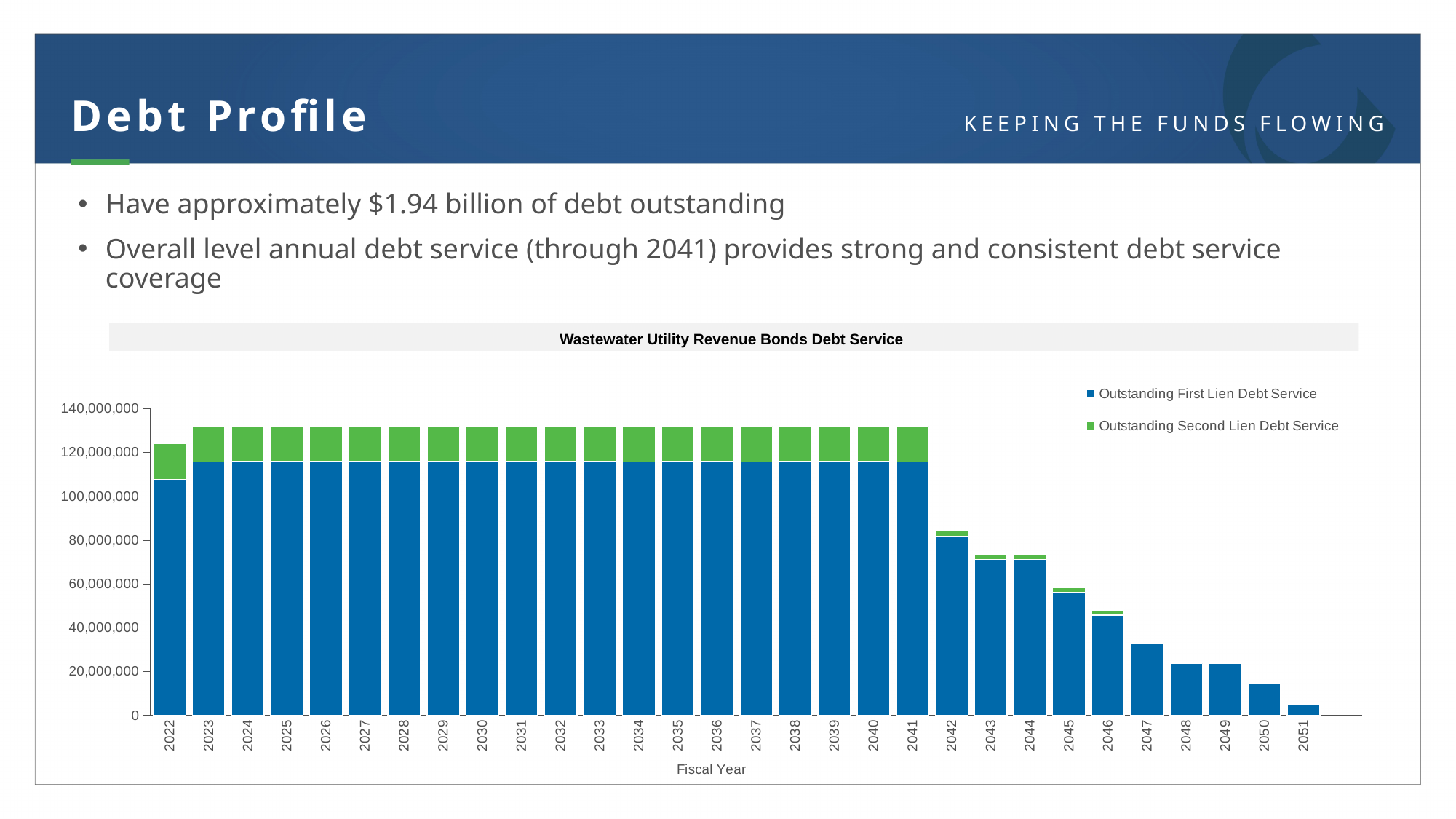
Which fiscal year has the larger total debt service, 2046 or 2047? 2046 How many fiscal years are shown on the x axis of the chart? 30 What are the two series named in the legend? Outstanding First Lien Debt Service; Outstanding Second Lien Debt Service How many series does the chart's legend list? 2 Is the Outstanding First Lien Debt Service for 2022 greater or less than 100,000,000? greater What kind of chart is shown on the slide? Stacked bar chart What is the title of the chart? Wastewater Utility Revenue Bonds Debt Service Is the total debt service for 2042 greater or less than 100,000,000? less Is the total debt service for 2050 greater or less than 20,000,000? less Do the total debt service values rise or fall along the x axis from 2041 to 2051? fall Which fiscal year has the lowest total debt service in the chart? 2051